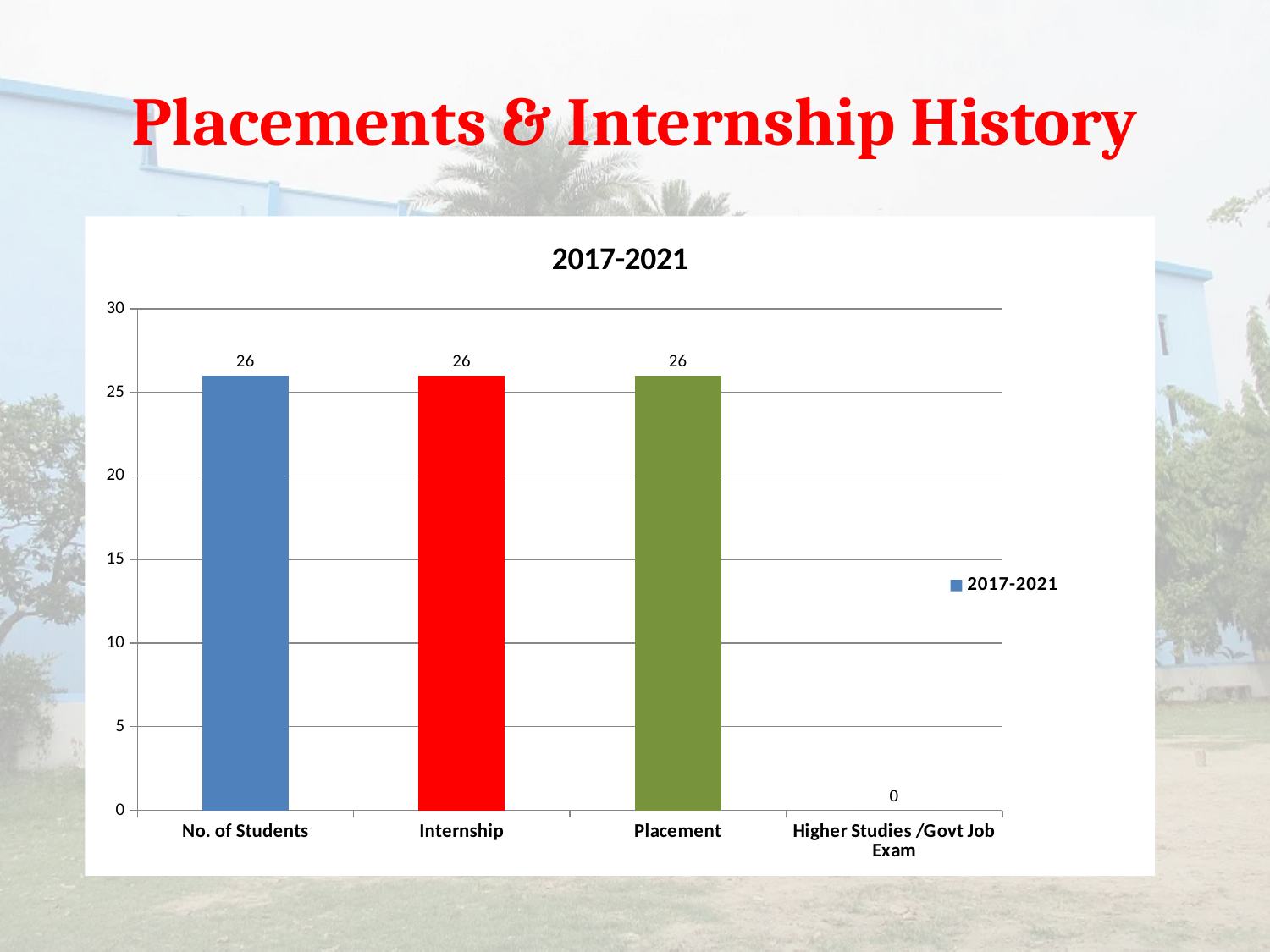
What is the difference between the values for Placement and Higher Studies /Govt Job Exam? 26 How many series does the legend list? 1 What kind of chart is shown on the slide? bar chart What is the value for Higher Studies /Govt Job Exam? 0 What is the title of the chart? 2017-2021 What is the value for No. of Students? 26 Which category has the lowest value? Higher Studies /Govt Job Exam What is the value for Placement? 26 What is the value for Internship? 26 How many categories are shown on the x axis? 4 Which is larger, the value for Internship or the value for Higher Studies /Govt Job Exam? Internship Is the value for Placement greater or less than 20? greater